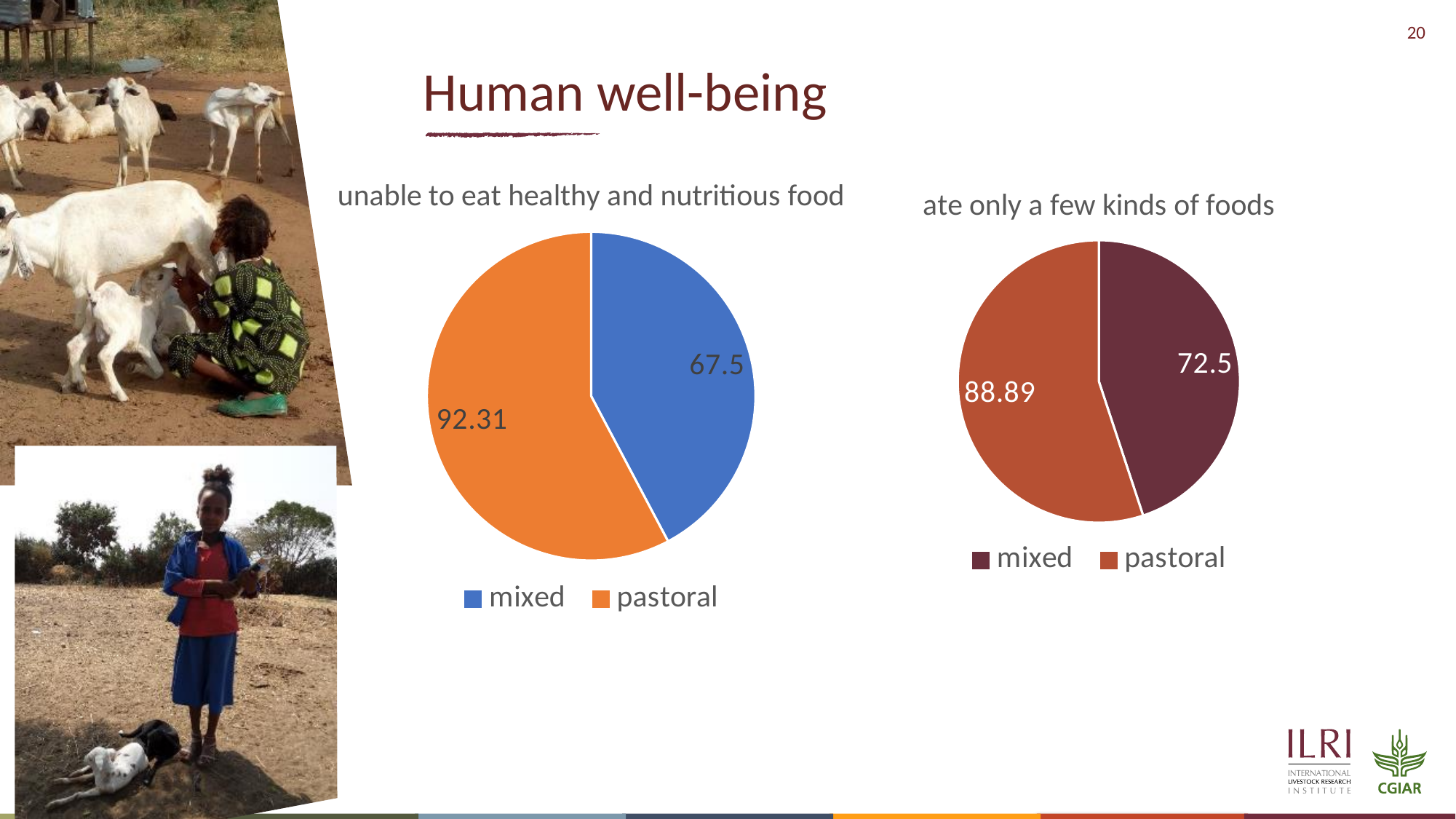
In the chart titled "ate only a few kinds of foods", what is the value for pastoral? 88.89 How many categories does the legend of the chart titled "unable to eat healthy and nutritious food" list? 2 What kind of chart is the chart titled "ate only a few kinds of foods"? pie chart In the chart titled "unable to eat healthy and nutritious food", what is the value for pastoral? 92.31 In the chart titled "unable to eat healthy and nutritious food", what is the difference between the pastoral and mixed values? 24.81 In the chart titled "unable to eat healthy and nutritious food", what colour is the pastoral slice? orange In the chart titled "ate only a few kinds of foods", which category has the lower value? mixed In the chart titled "unable to eat healthy and nutritious food", which category has the higher value? pastoral Is the mixed value larger in the chart titled "unable to eat healthy and nutritious food" or in the chart titled "ate only a few kinds of foods"? ate only a few kinds of foods In the chart titled "ate only a few kinds of foods", what is the difference between the pastoral and mixed values? 16.39 In the chart titled "ate only a few kinds of foods", what is the value for mixed? 72.5 In the chart titled "unable to eat healthy and nutritious food", what is the value for mixed? 67.5